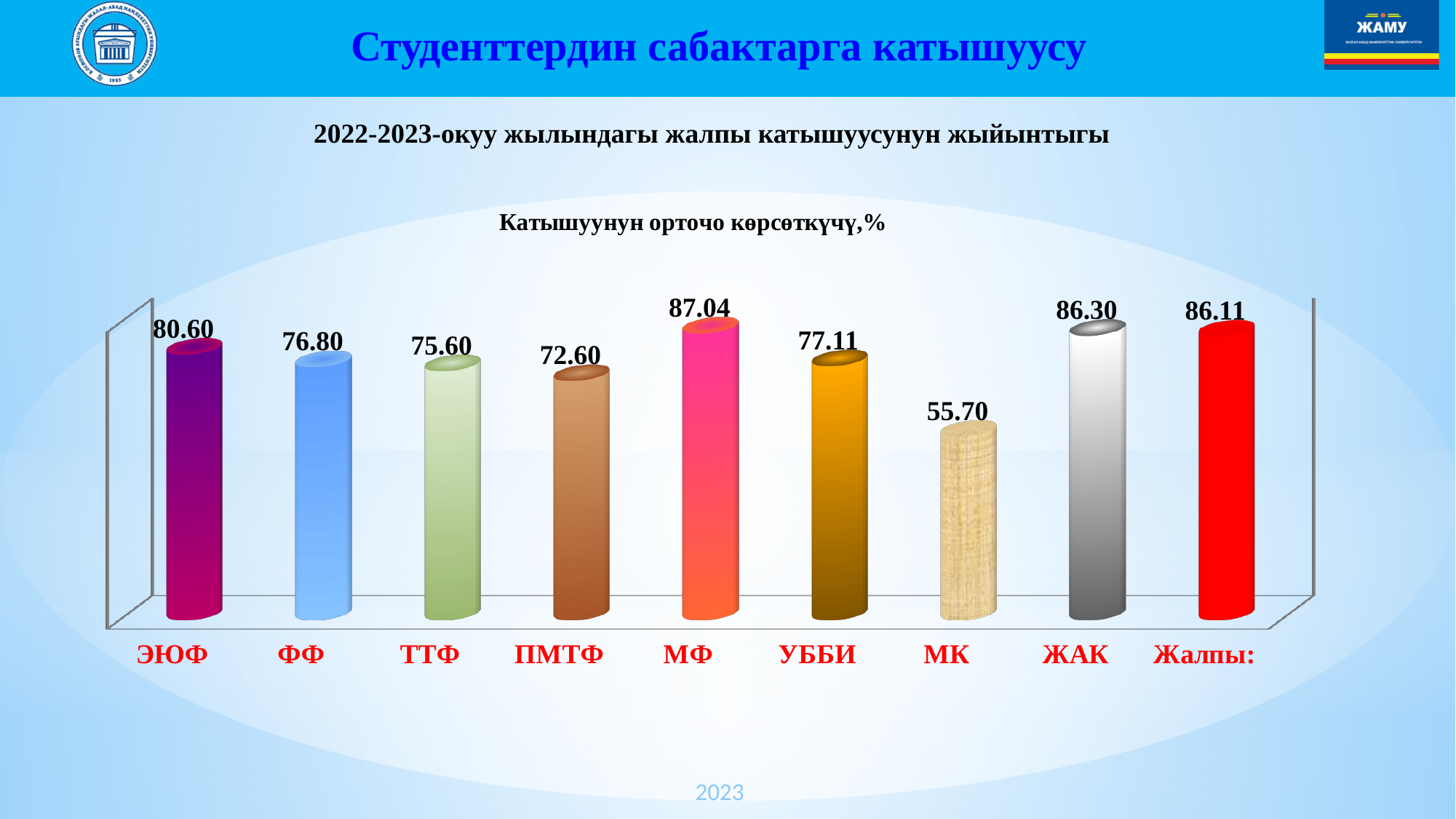
What is the value for ЭЮФ? 80.60 How many categories are shown on the x axis? 9 What is the difference between the values for ЭЮФ and ПМТФ? 8.00 What kind of chart is shown on the slide? bar chart What is the value for Жалпы:? 86.11 What is the difference between the values for ЖАК and МК? 30.60 Which is larger, the value for ФФ or the value for ТТФ? ФФ What is the value for МК? 55.70 What is the value for МФ? 87.04 Which category has the highest value? МФ What is the title of the chart? Катышуунун орточо көрсөткүчү,% Which category has the lowest value? МК